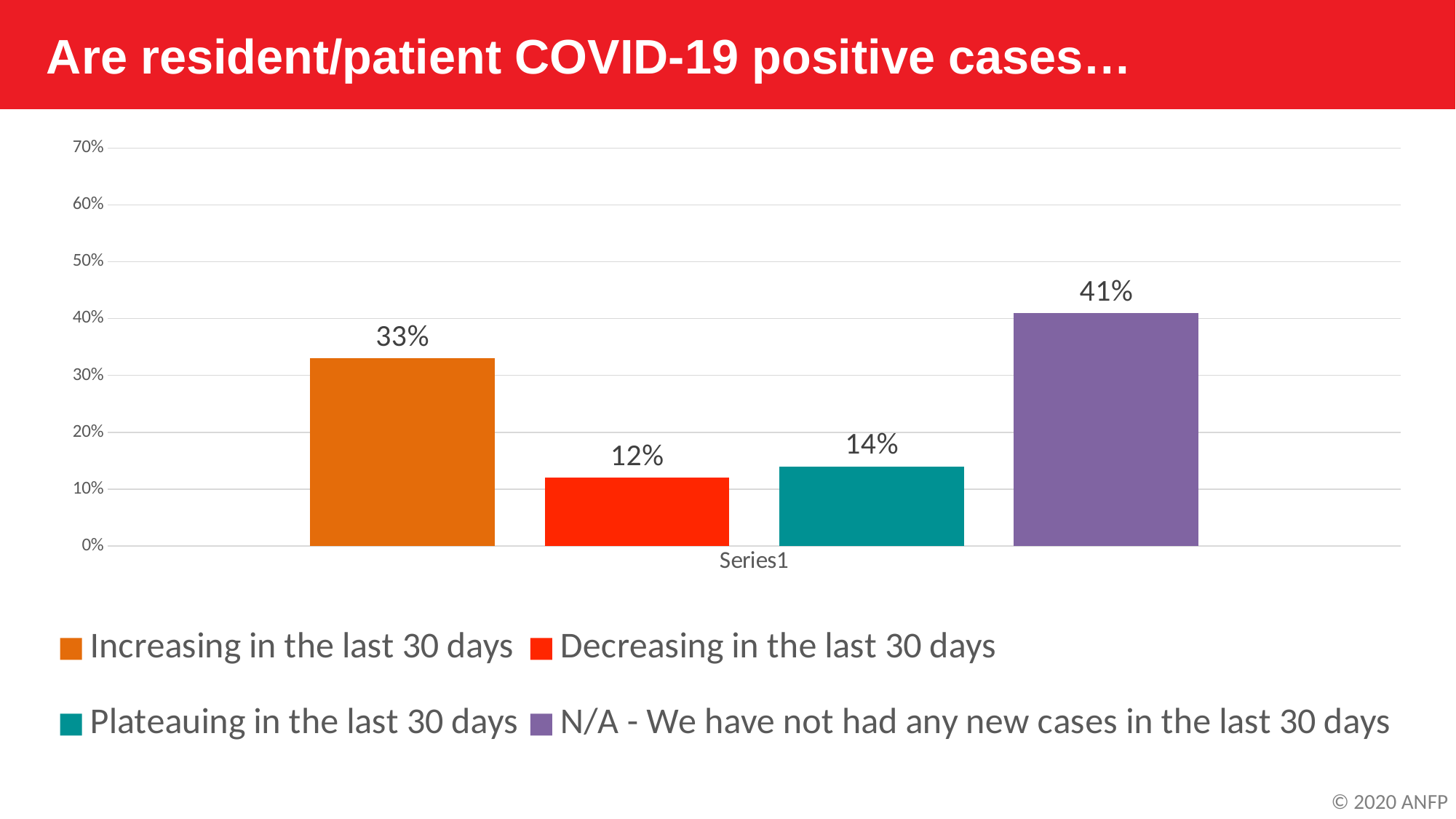
Which response has the lowest percentage? Decreasing in the last 30 days What type of chart is shown on the slide? Bar chart What percentage of respondents answered N/A - We have not had any new cases in the last 30 days? 41% Which response has the highest percentage? N/A - We have not had any new cases in the last 30 days Is the value for 'Increasing in the last 30 days' greater or less than 30%? greater What percentage of respondents said COVID-19 positive cases are increasing in the last 30 days? 33% Which is larger: the percentage for 'Increasing in the last 30 days' or 'Plateauing in the last 30 days'? Increasing in the last 30 days What percentage of respondents said COVID-19 positive cases are plateauing in the last 30 days? 14% What colour is the bar for 'Plateauing in the last 30 days'? Teal How many response categories are shown in the chart? 4 What percentage of respondents said COVID-19 positive cases are decreasing in the last 30 days? 12% What is the difference in percentage points between 'N/A - We have not had any new cases in the last 30 days' and 'Increasing in the last 30 days'? 8 percentage points